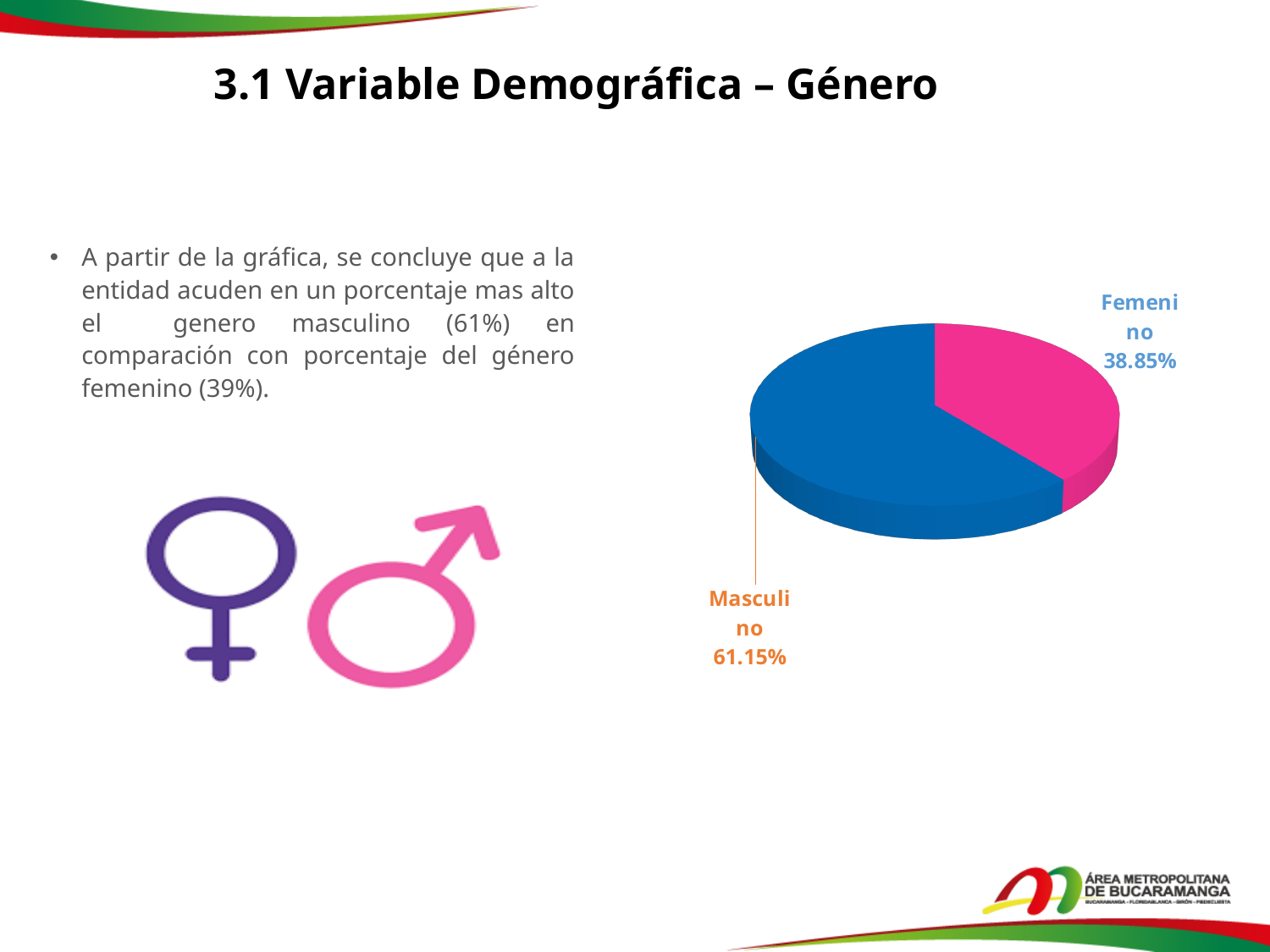
What colour is the Masculino slice? blue What colour is the Femenino slice? pink What share of the pie does the Femenino slice take? 38.85% How many slices does the pie chart have? 2 What kind of chart is shown on the slide? pie chart What percentage does the Femenino slice represent? 38.85% What percentage does the Masculino slice represent? 61.15% Which slice of the pie is the smallest? Femenino Which slice of the pie is the largest? Masculino Which is larger, the Masculino slice or the Femenino slice? Masculino What is the difference in percentage points between the Masculino and Femenino slices? 22.3